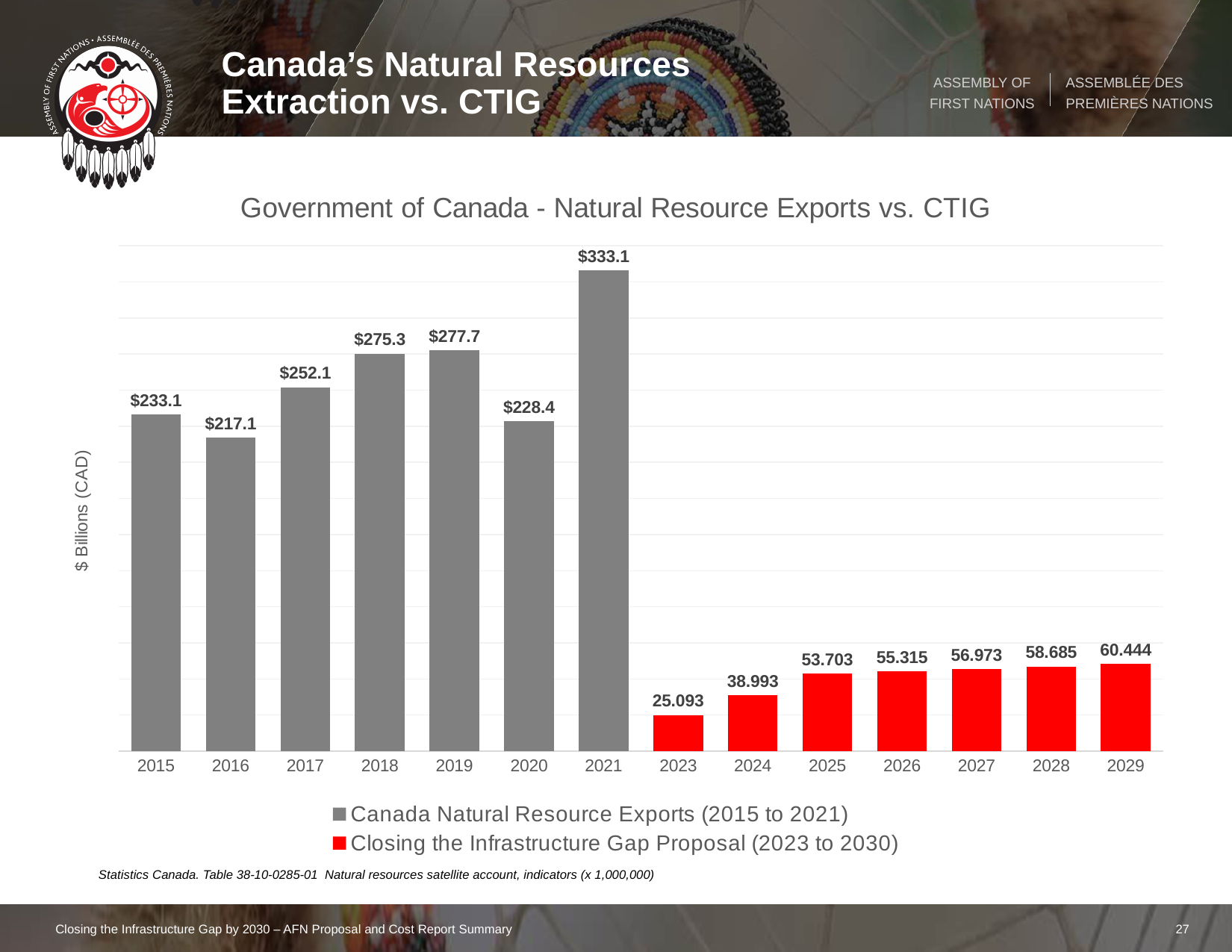
Which is larger, the Canada Natural Resource Exports value for 2015 or for 2020? 2015 Which year has the lowest value for the Closing the Infrastructure Gap Proposal? 2023 Do the Closing the Infrastructure Gap Proposal values rise or fall from 2023 to 2029? Rise Which year has the highest value for Canada Natural Resource Exports? 2021 How many years are shown on the x axis? 14 What is the value for the Closing the Infrastructure Gap Proposal in 2023? 25.093 What kind of chart is shown on the slide? Bar chart How many series does the legend list? 2 What is the value for the Closing the Infrastructure Gap Proposal in 2029? 60.444 What is the difference between the Canada Natural Resource Exports values for 2021 and 2020? $104.7 What is the value for Canada Natural Resource Exports in 2016? $217.1 What is the value for Canada Natural Resource Exports in 2021? $333.1